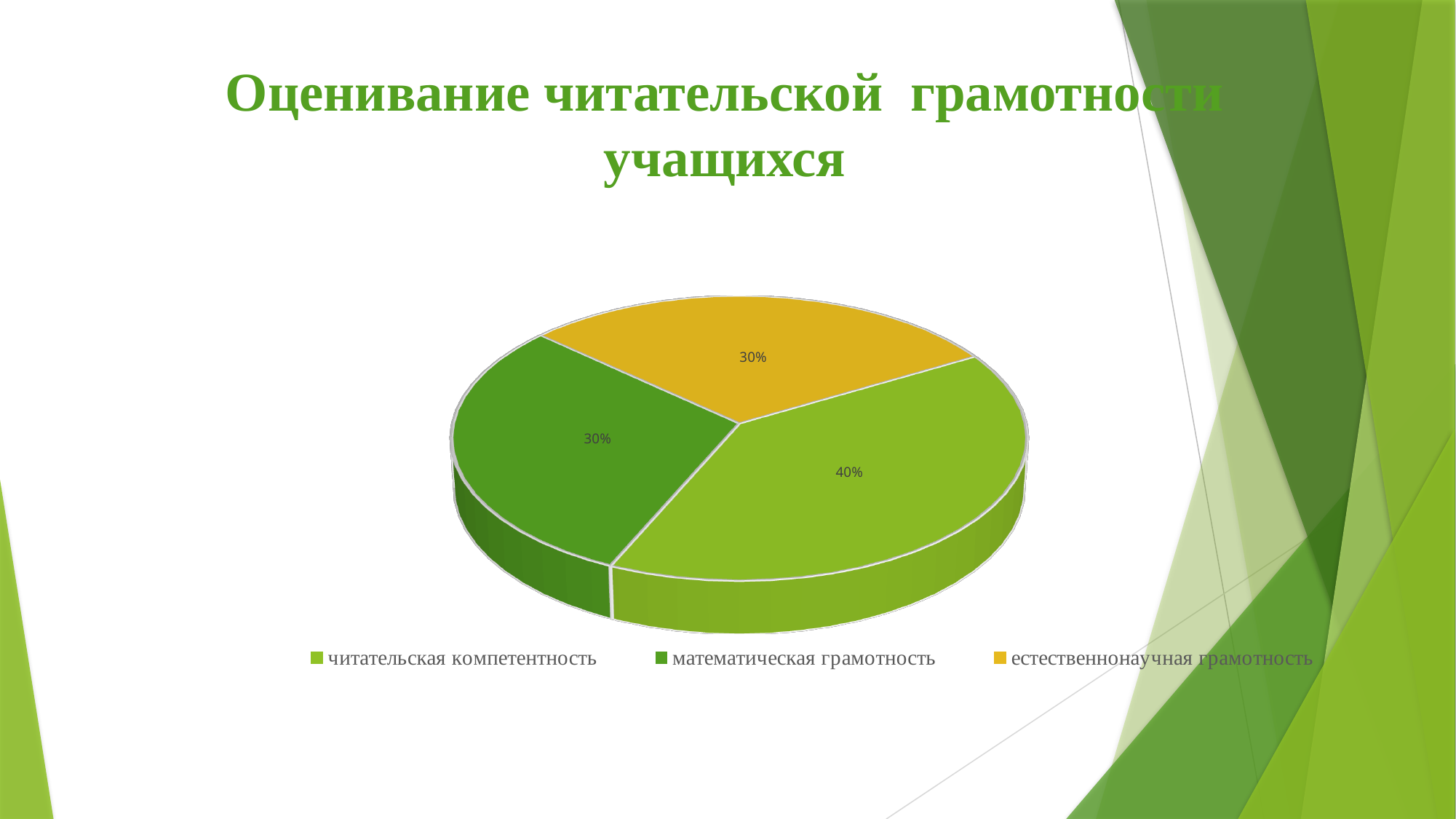
What share of the pie does математическая грамотность have? 30% How many entries does the legend list? 3 What kind of chart is shown on the slide? pie chart What is the difference between the shares of читательская компетентность and математическая грамотность? 10% Is the share for читательская компетентность greater or less than 50%? less What colour is the slice for естественнонаучная грамотность? yellow What is the title of the slide containing the pie chart? Оценивание читательской грамотности учащихся What share of the pie does естественнонаучная грамотность have? 30% Which is larger: the slice for читательская компетентность or the slice for естественнонаучная грамотность? читательская компетентность How many slices does the pie chart have? 3 What share of the pie does читательская компетентность have? 40% Which category has the largest slice of the pie? читательская компетентность